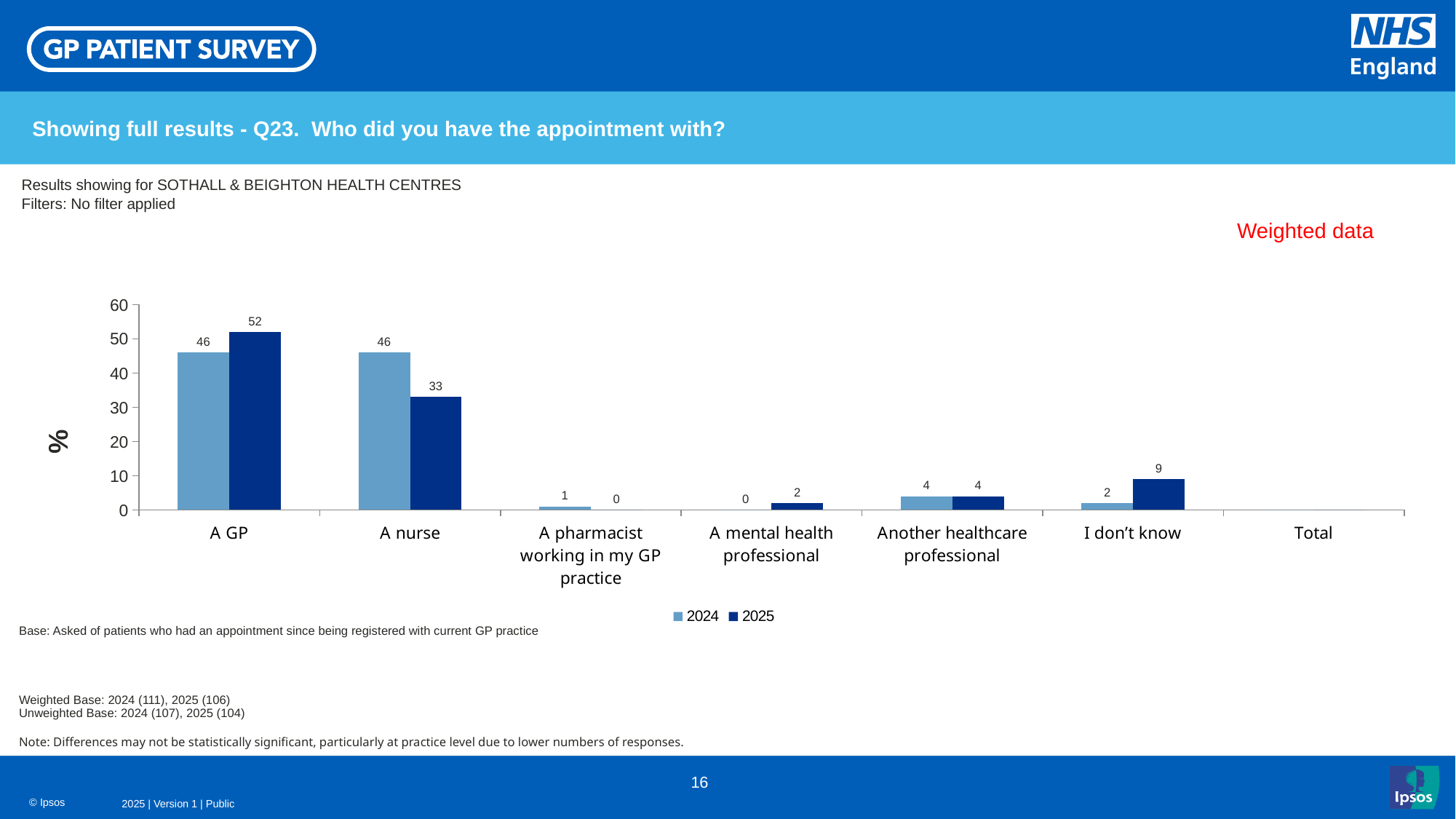
Which is larger for I don't know, the 2024 value or the 2025 value? 2025 What is the 2025 value for A mental health professional? 2 Which category has the highest 2025 value? A GP What is the difference between the 2024 and 2025 values for A nurse? 13 What is the 2025 value for A GP? 52 Is the 2025 value for A GP greater or less than 50? greater What kind of chart is shown on the slide? Bar chart What is the 2025 value for I don't know? 9 What is the 2024 value for A nurse? 46 How many series does the legend list? 2 What is the difference between the 2025 and 2024 values for A GP? 6 What is the 2024 value for A pharmacist working in my GP practice? 1